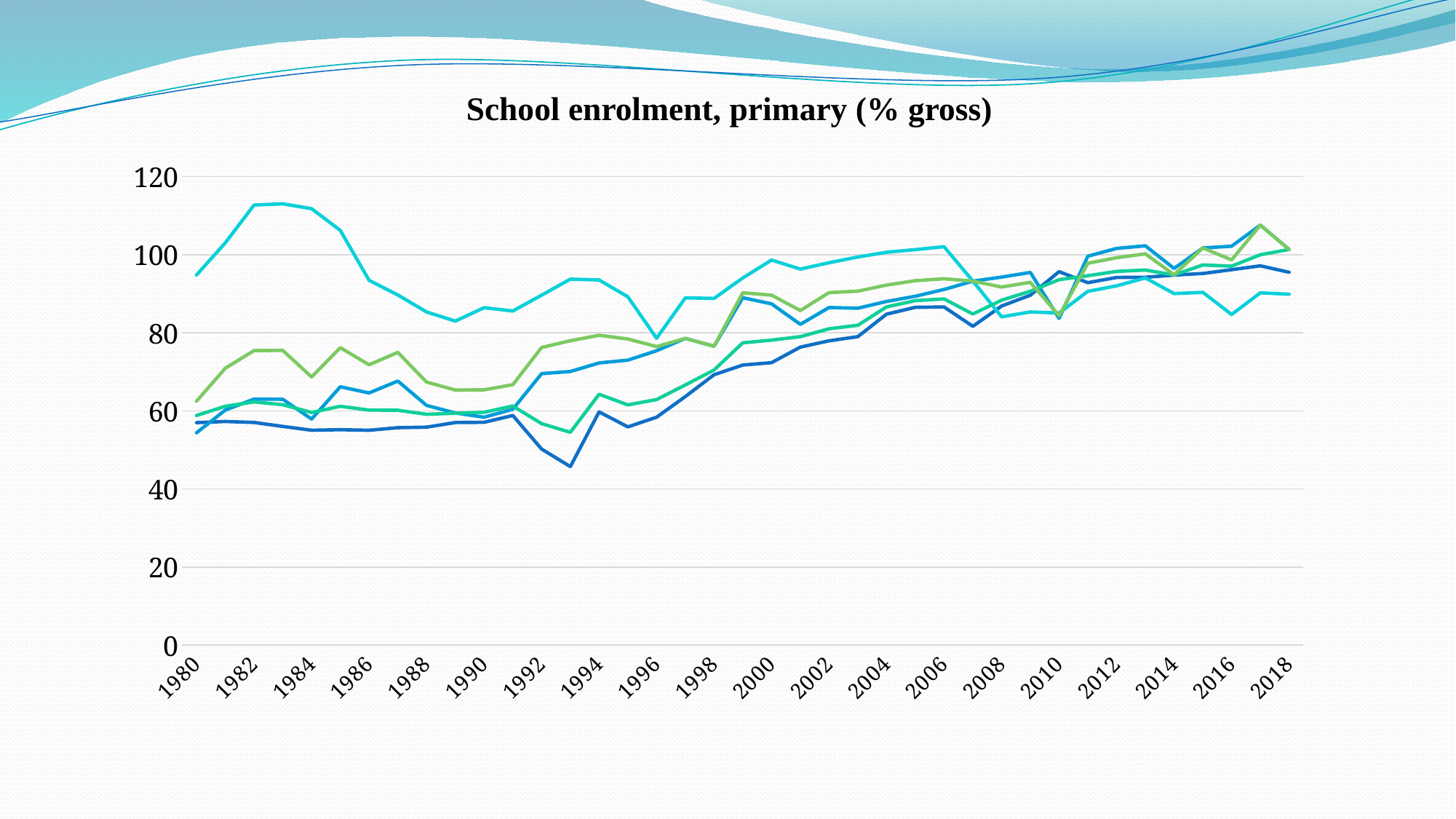
Is the value of the highest line in 1982 greater or less than 100? greater Is the lowest line's value in 1980 greater or less than 60? less Do the plotted lines generally rise or fall from 1980 to 2018? Rise How many year labels are shown on the x axis? 20 What is the last year shown on the x axis? 2018 In 2018, are all the lines above or below 80? above What is the title of the chart? School enrolment, primary (% gross) How many lines are plotted on the chart? 5 What kind of chart is shown on the slide? Line chart What is the first year shown on the x axis? 1980 What is the highest value marked on the y axis? 120